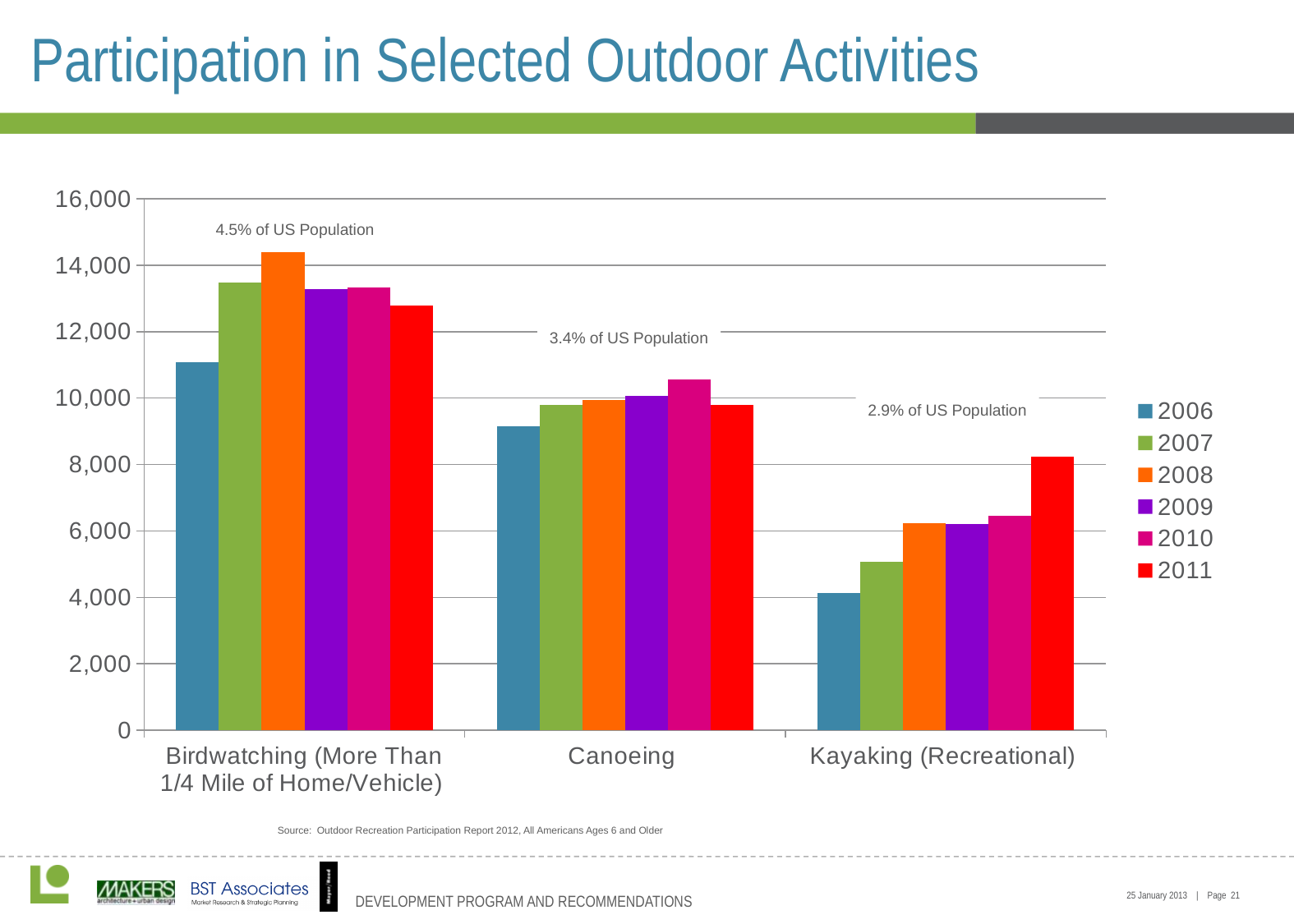
Do the values for Kayaking (Recreational) generally rise or fall from 2006 to 2011? rise How many activity categories are shown on the x axis? 3 Which year has the lowest value for Kayaking (Recreational)? 2006 What colour represents 2011 in the legend? Red What kind of chart is shown on the slide? Bar chart Which year has the highest value for Birdwatching (More Than 1/4 Mile of Home/Vehicle)? 2008 What annotation is printed above the Canoeing bars? 3.4% of US Population Is the 2011 value for Kayaking (Recreational) greater or less than 6,000? greater Is the 2006 value for Birdwatching (More Than 1/4 Mile of Home/Vehicle) greater or less than 12,000? less Which is larger: the 2010 value for Canoeing or the 2011 value for Kayaking (Recreational)? Canoeing 2010 How many series does the legend list? 6 Is the 2006 value for Canoeing greater or less than 10,000? less